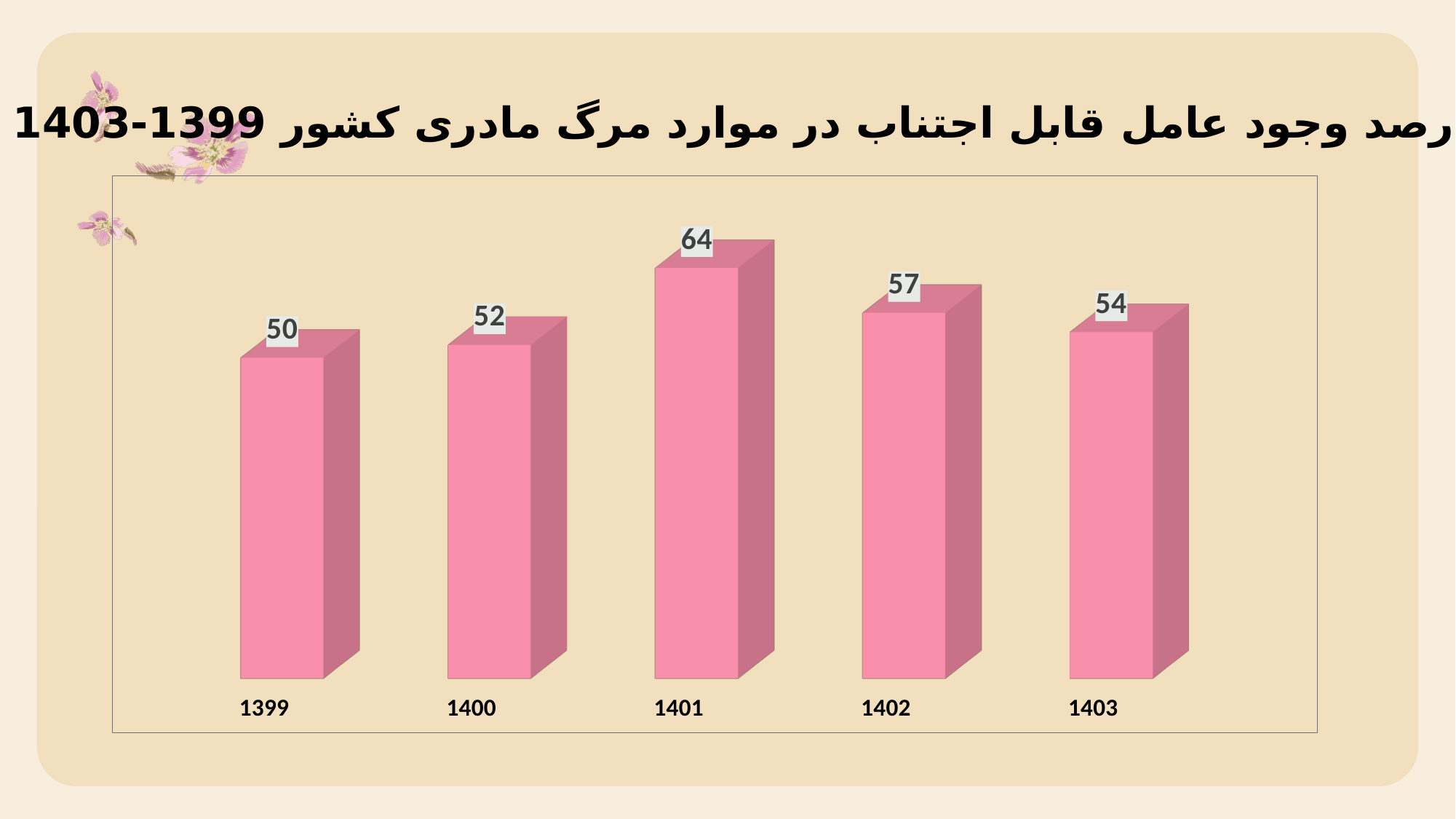
What is the value for 1402? 57 What is the value for 1403? 54 What is the value for 1401? 64 Which is larger, the value for 1400 or the value for 1403? 1403 Do the values rise or fall from 1401 to 1403? Fall What is the value for 1399? 50 How many years are shown on the chart? 5 Which year has the highest value? 1401 What is the difference between the values for 1402 and 1403? 3 What is the difference between the values for 1401 and 1399? 14 What kind of chart is shown on the slide? Bar chart Which year has the lowest value? 1399